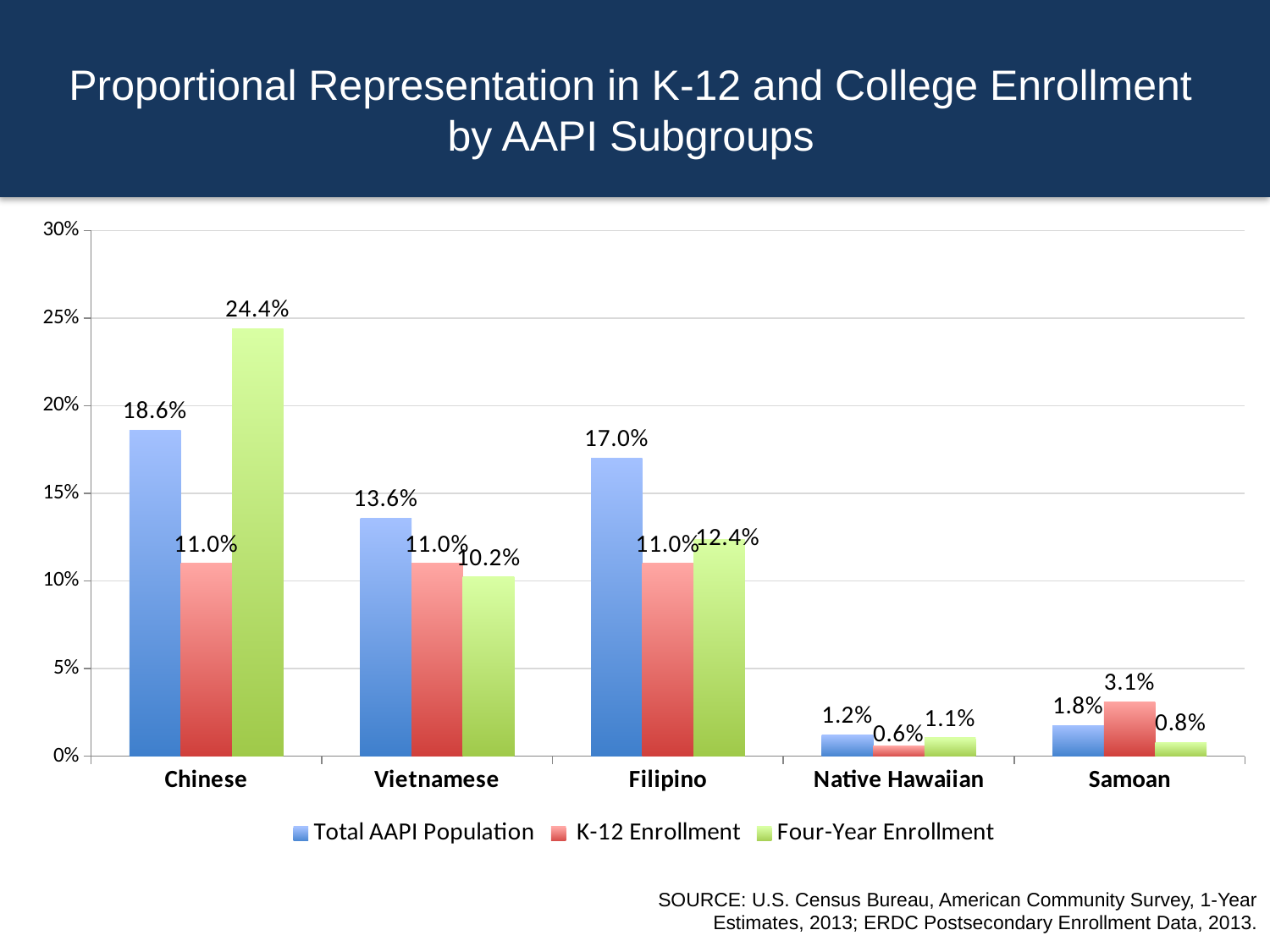
Which subgroup has the lowest K-12 Enrollment value? Native Hawaiian How many subgroups are shown on the x axis? 5 Which is larger for Vietnamese: Total AAPI Population or Four-Year Enrollment? Total AAPI Population What kind of chart is shown on the slide? Bar chart What is the Four-Year Enrollment value for Native Hawaiian? 1.1% What is the Four-Year Enrollment value for Chinese? 24.4% How many series does the legend list? 3 What is the difference between the Four-Year Enrollment and Total AAPI Population values for Chinese? 5.8% What is the Total AAPI Population value for Filipino? 17.0% Is the Total AAPI Population value for Filipino greater or less than 15%? greater What is the K-12 Enrollment value for Samoan? 3.1% Which subgroup has the highest Four-Year Enrollment value? Chinese